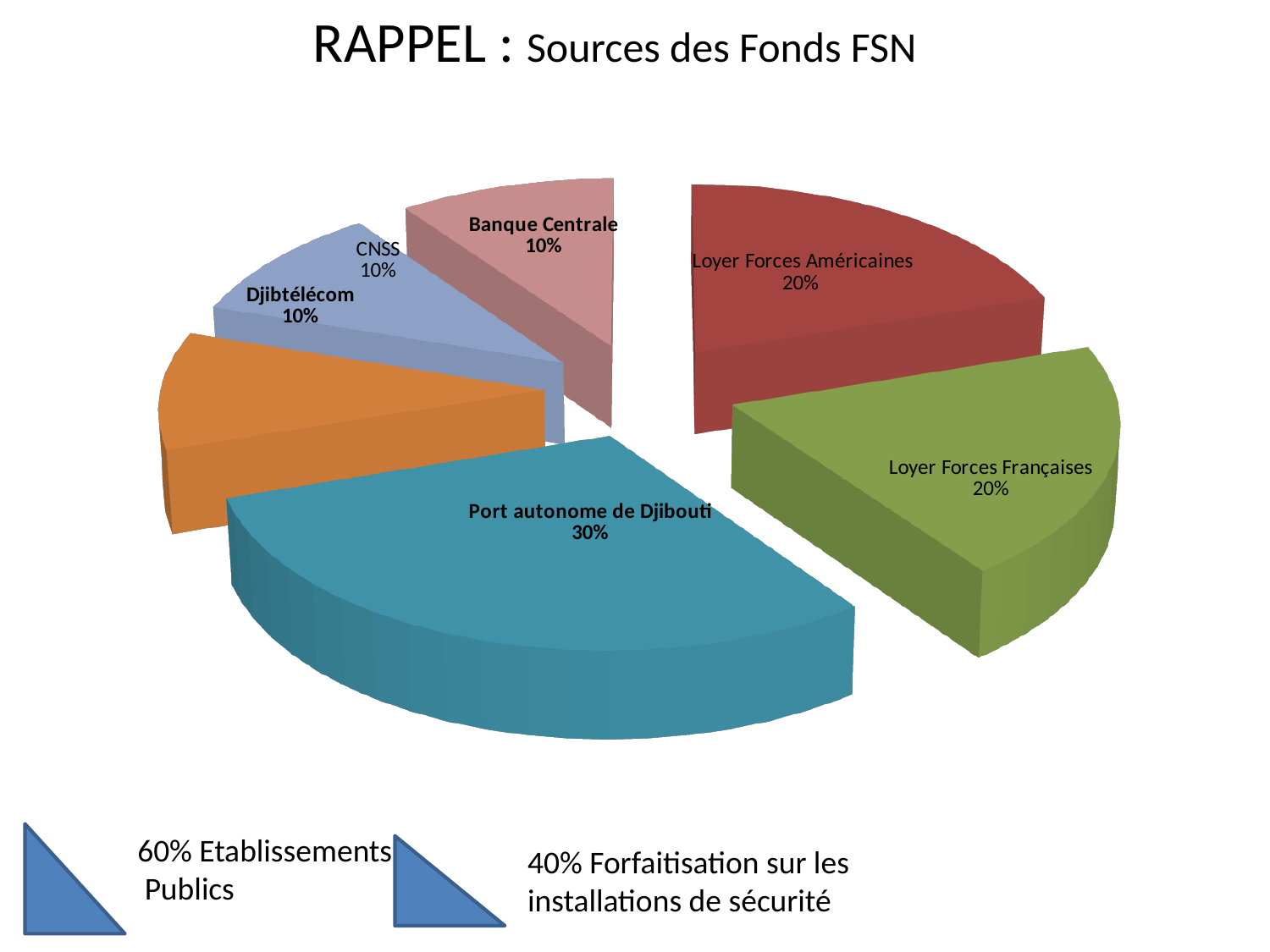
What is the combined share of Loyer Forces Américaines and Loyer Forces Françaises? 40% What is the title of the slide containing the pie chart? RAPPEL : Sources des Fonds FSN What kind of chart is shown on the slide? pie chart Which source has the largest share of the FSN funds? Port autonome de Djibouti What is the value shown for CNSS? 10% What is the difference between the share of Port autonome de Djibouti and the share of Loyer Forces Françaises? 10% What is the value shown for Loyer Forces Américaines? 20% How many slices does the pie chart have? 6 What share of the pie does Port autonome de Djibouti represent? 30% Which is larger, the share of Loyer Forces Françaises or the share of Djibtélécom? Loyer Forces Françaises What colour is the Port autonome de Djibouti slice? teal What is the value shown for Banque Centrale? 10%